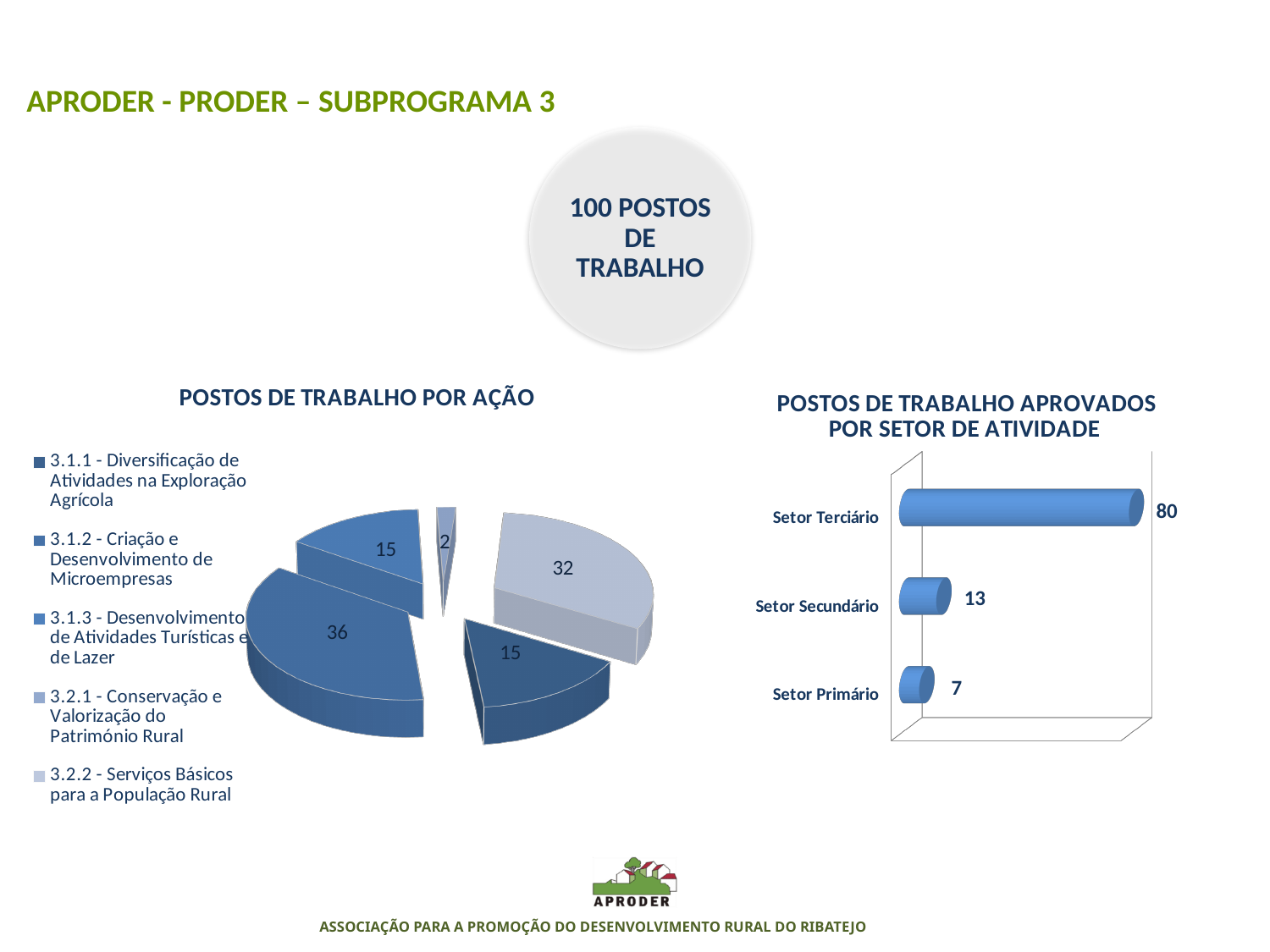
What kind of chart is 'POSTOS DE TRABALHO APROVADOS POR SETOR DE ATIVIDADE'? Bar chart In the chart 'POSTOS DE TRABALHO APROVADOS POR SETOR DE ATIVIDADE', what is the value for Setor Secundário? 13 In the chart 'POSTOS DE TRABALHO POR AÇÃO', what is the value of the largest slice? 36 In the chart 'POSTOS DE TRABALHO APROVADOS POR SETOR DE ATIVIDADE', what is the difference between Setor Terciário and Setor Secundário? 67 In the chart 'POSTOS DE TRABALHO APROVADOS POR SETOR DE ATIVIDADE', what is the value for Setor Terciário? 80 In the chart 'POSTOS DE TRABALHO APROVADOS POR SETOR DE ATIVIDADE', how many sectors are shown? 3 In the chart 'POSTOS DE TRABALHO POR AÇÃO', how many entries does the legend list? 5 In the chart 'POSTOS DE TRABALHO APROVADOS POR SETOR DE ATIVIDADE', which is larger, Setor Secundário or Setor Primário? Setor Secundário What kind of chart is 'POSTOS DE TRABALHO POR AÇÃO'? Pie chart In the chart 'POSTOS DE TRABALHO APROVADOS POR SETOR DE ATIVIDADE', which sector has the lowest value? Setor Primário In the chart 'POSTOS DE TRABALHO APROVADOS POR SETOR DE ATIVIDADE', what is the value for Setor Primário? 7 In the chart 'POSTOS DE TRABALHO APROVADOS POR SETOR DE ATIVIDADE', which sector has the highest value? Setor Terciário